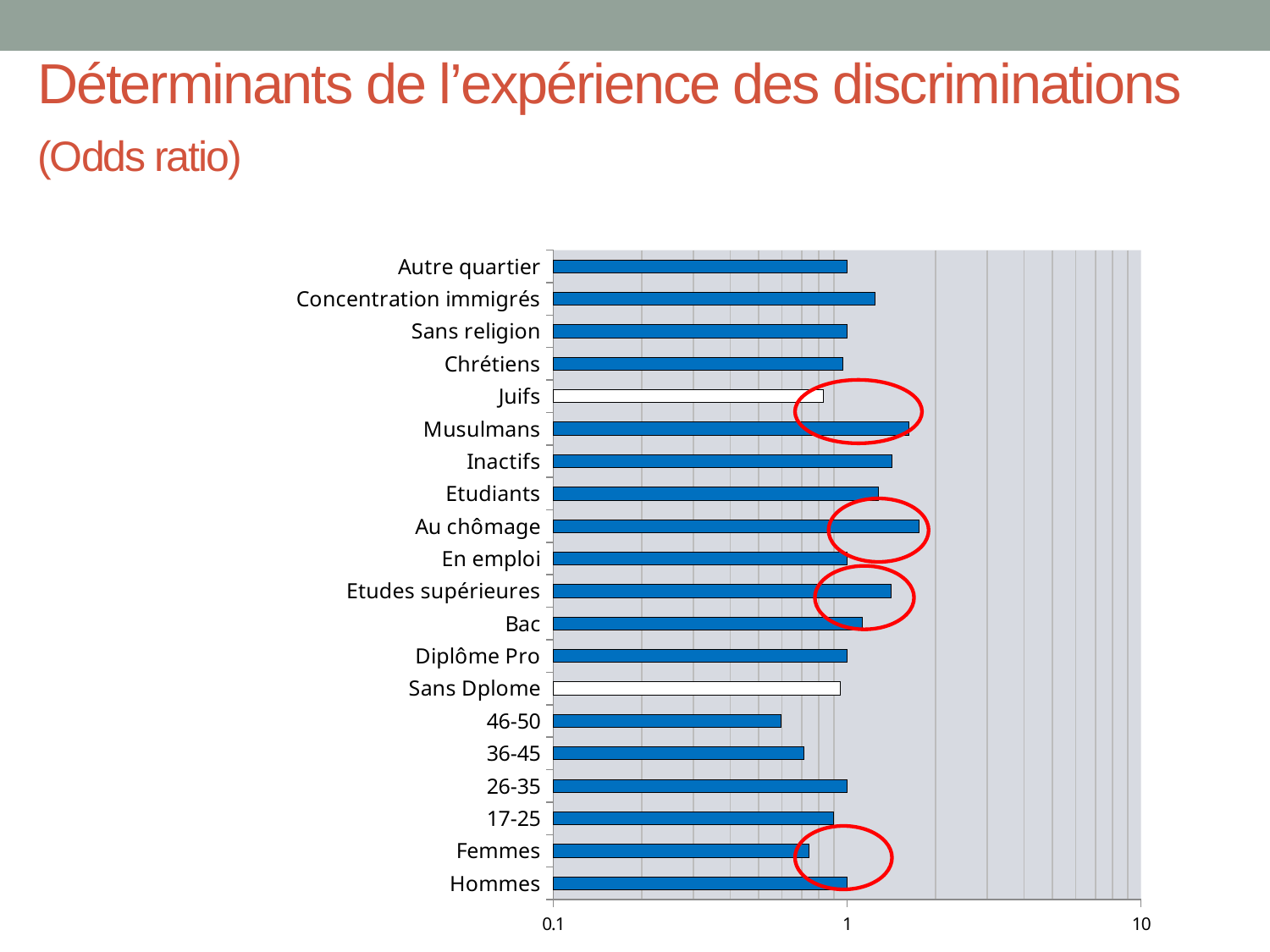
Is the value for Femmes greater or less than 1? less What kind of chart is shown on the slide? bar chart Is the value for 36-45 greater or less than 1? less Which has the larger value, Au chômage or 46-50? Au chômage Which category has the lowest odds ratio on the chart? 46-50 How many categories are plotted on the chart? 20 Is the value for Inactifs greater or less than 1? greater What is the highest value shown on the x axis of the chart? 10 What is the title of the slide containing the chart? Déterminants de l'expérience des discriminations (Odds ratio)